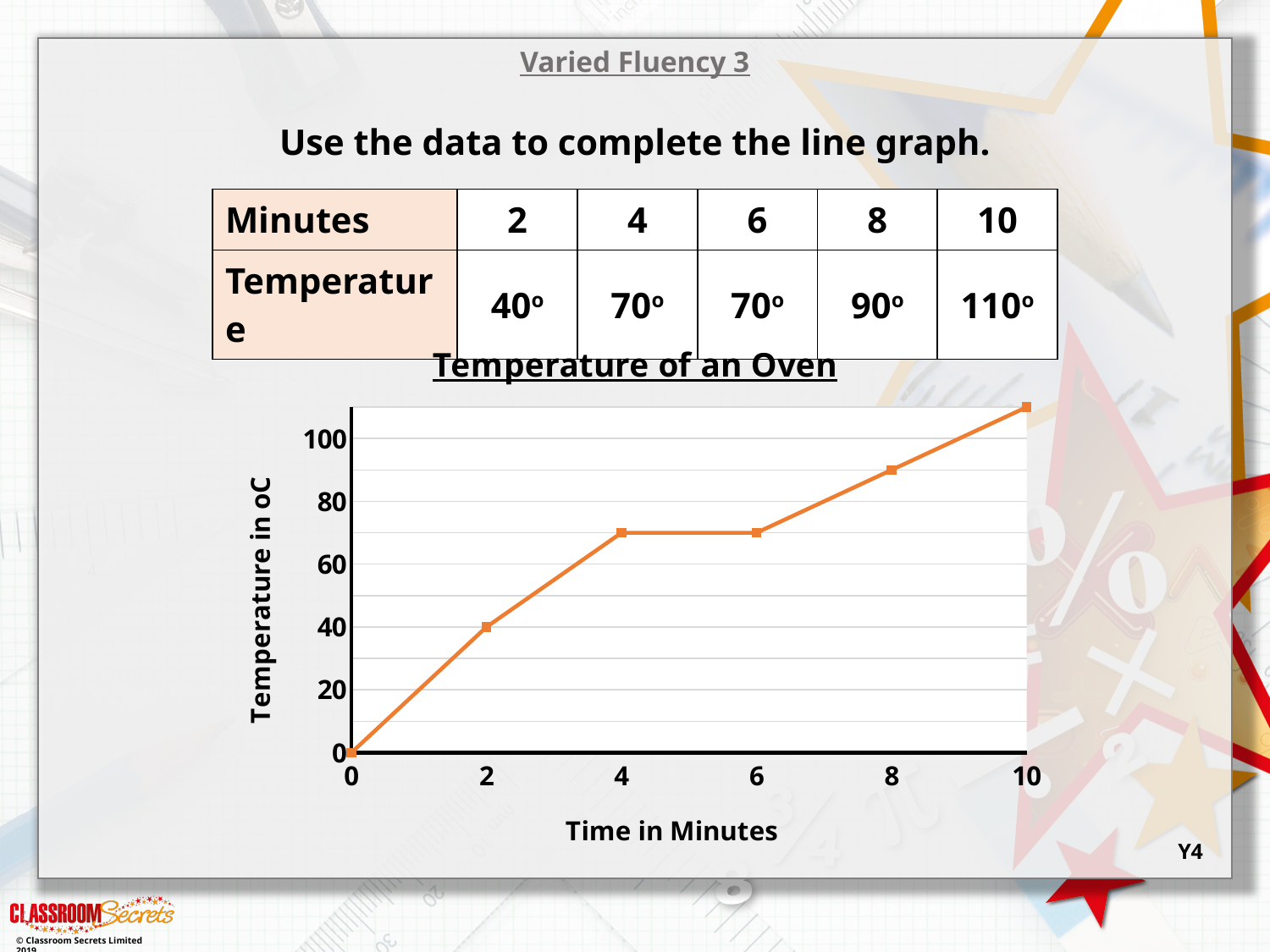
Does the temperature generally rise or fall as time increases? rise What is the temperature at 2 minutes? 40° Is the temperature at 6 minutes greater or less than 60? greater What is the temperature at 10 minutes? 110° What is the title of the chart? Temperature of an Oven What is the label of the y axis? Temperature in oC What is the temperature at 8 minutes? 90° What is the difference in temperature between 10 minutes and 2 minutes? 70° Which is higher, the temperature at 4 minutes or at 8 minutes? 8 minutes What kind of chart is shown on the slide? line chart At which time in minutes is the temperature highest? 10 What is the difference in temperature between 8 minutes and 6 minutes? 20°